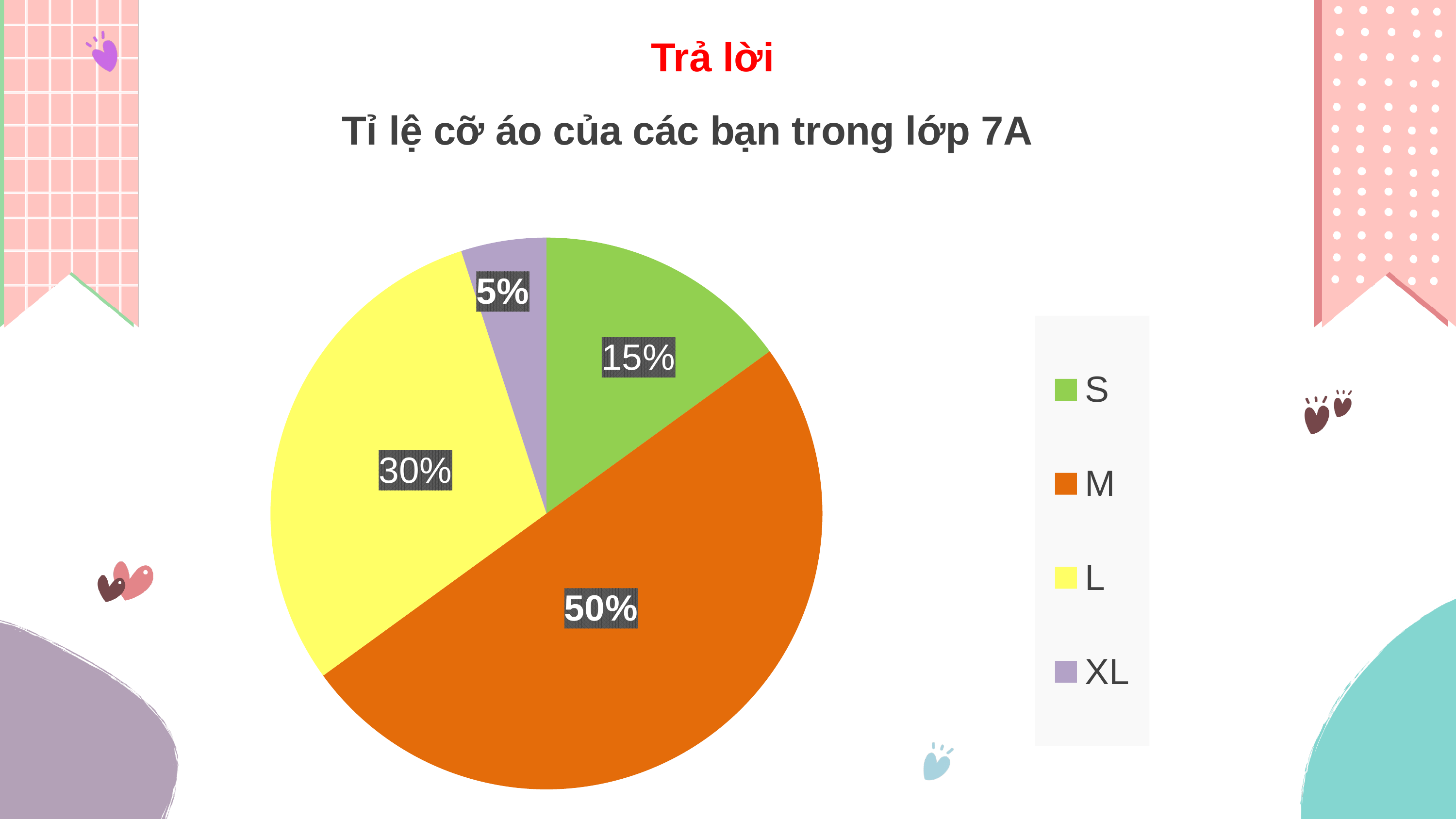
What percentage of the pie does size S represent? 15% What is the difference in percentage points between size M and size L? 20% What percentage of the pie does size XL represent? 5% What percentage of the pie does size L represent? 30% Which size has the largest share of the pie? M What colour is the slice for size L? yellow Which has a larger share, size S or size L? L Which size has the smallest share of the pie? XL How many categories does the legend list? 4 What is the title of the chart? Tỉ lệ cỡ áo của các bạn trong lớp 7A What type of chart is shown on the slide? pie chart What percentage of the pie does size M represent? 50%